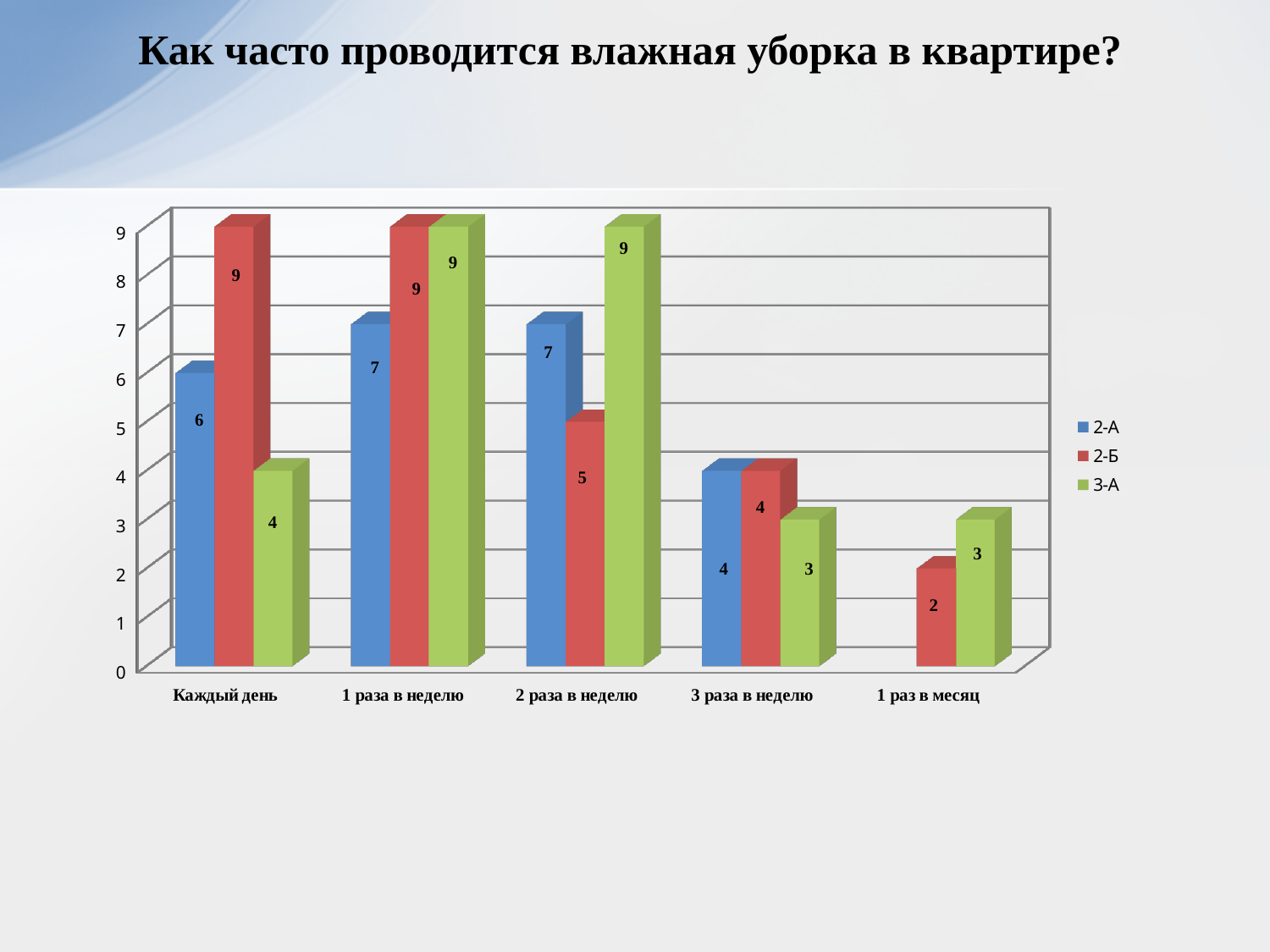
What is the title of the chart? Как часто проводится влажная уборка в квартире? What is the value for 2-Б in the '1 раз в месяц' category? 2 How many series does the legend list? 3 How many categories are shown on the x axis? 5 What kind of chart is shown on the slide? bar chart What is the value for 3-А in the '2 раза в неделю' category? 9 Which is larger in the '2 раза в неделю' category: the value for 2-А or for 2-Б? 2-А What is the value for 2-Б in the 'Каждый день' category? 9 What is the value for 2-А in the '3 раза в неделю' category? 4 What is the difference between the 2-Б and 3-А values in the 'Каждый день' category? 5